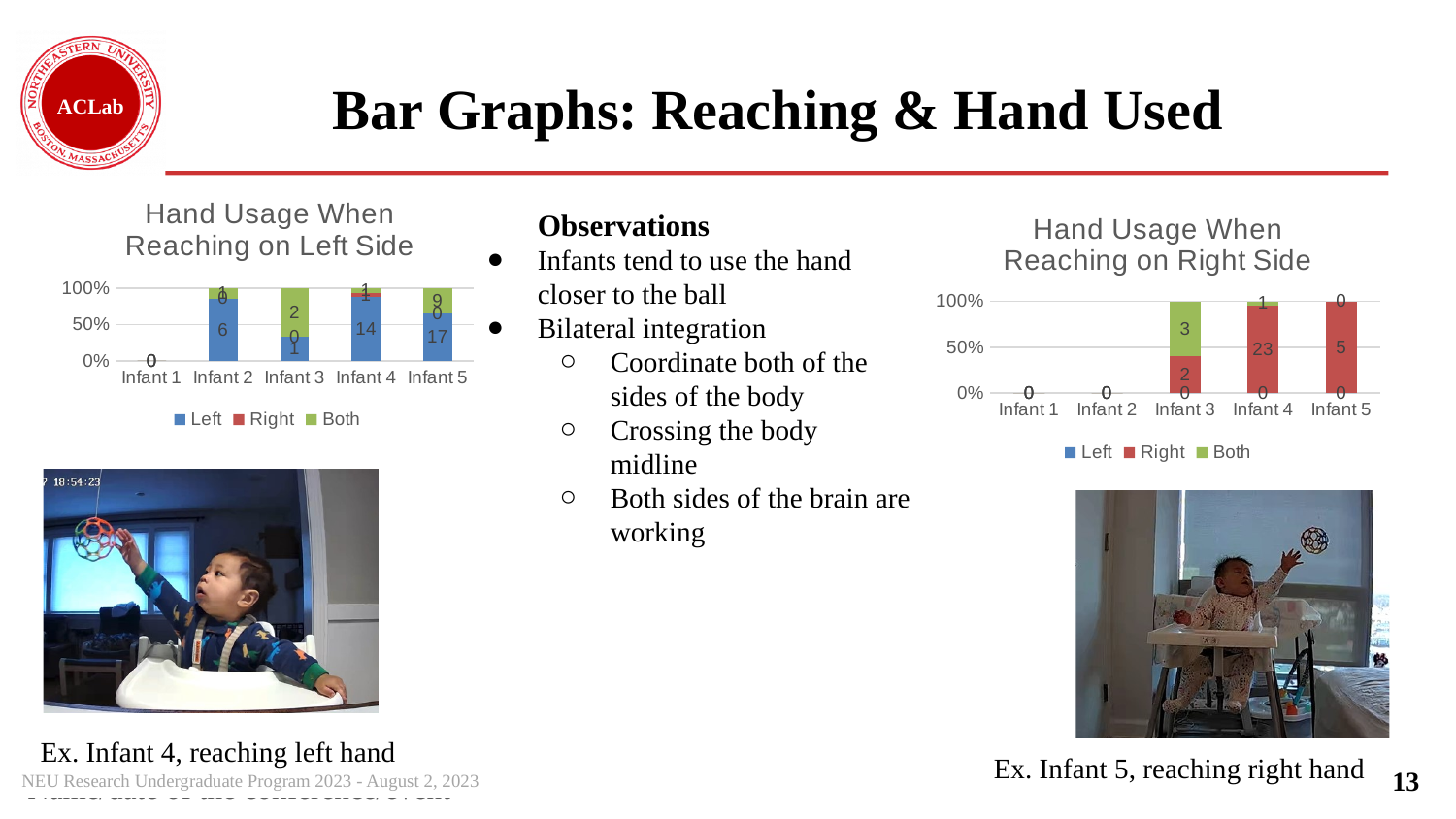
In the 'Hand Usage When Reaching on Right Side' chart, what is the Both value for Infant 3? 3 In the 'Hand Usage When Reaching on Left Side' chart, what is the Left value for Infant 4? 14 In the 'Hand Usage When Reaching on Right Side' chart, what is the Right value for Infant 4? 23 In the 'Hand Usage When Reaching on Left Side' chart, what is the difference between the Left values for Infant 5 and Infant 4? 3 How many series does the legend of the 'Hand Usage When Reaching on Right Side' chart list? 3 In the 'Hand Usage When Reaching on Right Side' chart, what is the total of the stacked bar for Infant 3? 5 In the 'Hand Usage When Reaching on Left Side' chart, what is the Left value for Infant 2? 6 In the 'Hand Usage When Reaching on Left Side' chart, what is the Left value for Infant 5? 17 How many infants are shown on the x axis of the 'Hand Usage When Reaching on Left Side' chart? 5 In the 'Hand Usage When Reaching on Right Side' chart, what is the Right value for Infant 5? 5 In the 'Hand Usage When Reaching on Left Side' chart, what is the Both value for Infant 3? 2 In the 'Hand Usage When Reaching on Left Side' chart, which is larger, the Left value for Infant 4 or the Left value for Infant 5? Infant 5